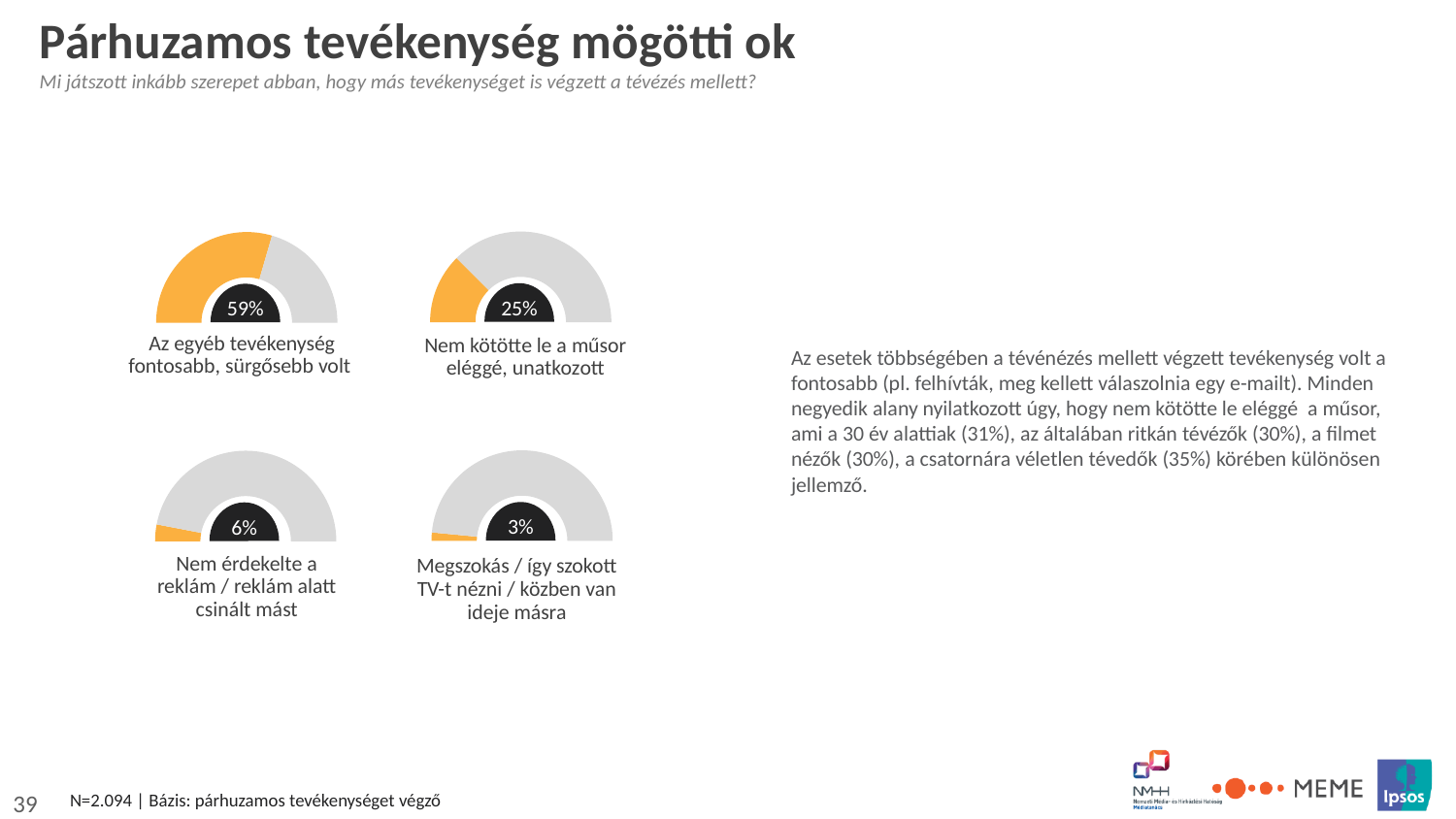
Across the four gauge charts on the slide, which reason has the highest value? Az egyéb tevékenység fontosabb, sürgősebb volt Across the four gauge charts on the slide, which reason has the lowest value? Megszokás / így szokott TV-t nézni / közben van ideje másra What value is shown on the gauge chart labelled "Megszokás / így szokott TV-t nézni / közben van ideje másra"? 3% What is the difference between the value on the "Nem érdekelte a reklám / reklám alatt csinált mást" gauge and the value on the "Megszokás / így szokott TV-t nézni / közben van ideje másra" gauge? 3 percentage points What value is shown on the gauge chart labelled "Az egyéb tevékenység fontosabb, sürgősebb volt"? 59% What colour is used for the filled portion of the gauge charts on the slide? Orange What value is shown on the gauge chart labelled "Nem kötötte le a műsor eléggé, unatkozott"? 25% What value is shown on the gauge chart labelled "Nem érdekelte a reklám / reklám alatt csinált mást"? 6% How many gauge charts are shown on the slide? 4 Which is larger: the value on the "Nem kötötte le a műsor eléggé, unatkozott" gauge or the value on the "Nem érdekelte a reklám / reklám alatt csinált mást" gauge? Nem kötötte le a műsor eléggé, unatkozott What kind of chart is used to display each value on the slide? Gauge (semi-donut) chart What is the difference between the value on the "Az egyéb tevékenység fontosabb, sürgősebb volt" gauge and the value on the "Nem kötötte le a műsor eléggé, unatkozott" gauge? 34 percentage points